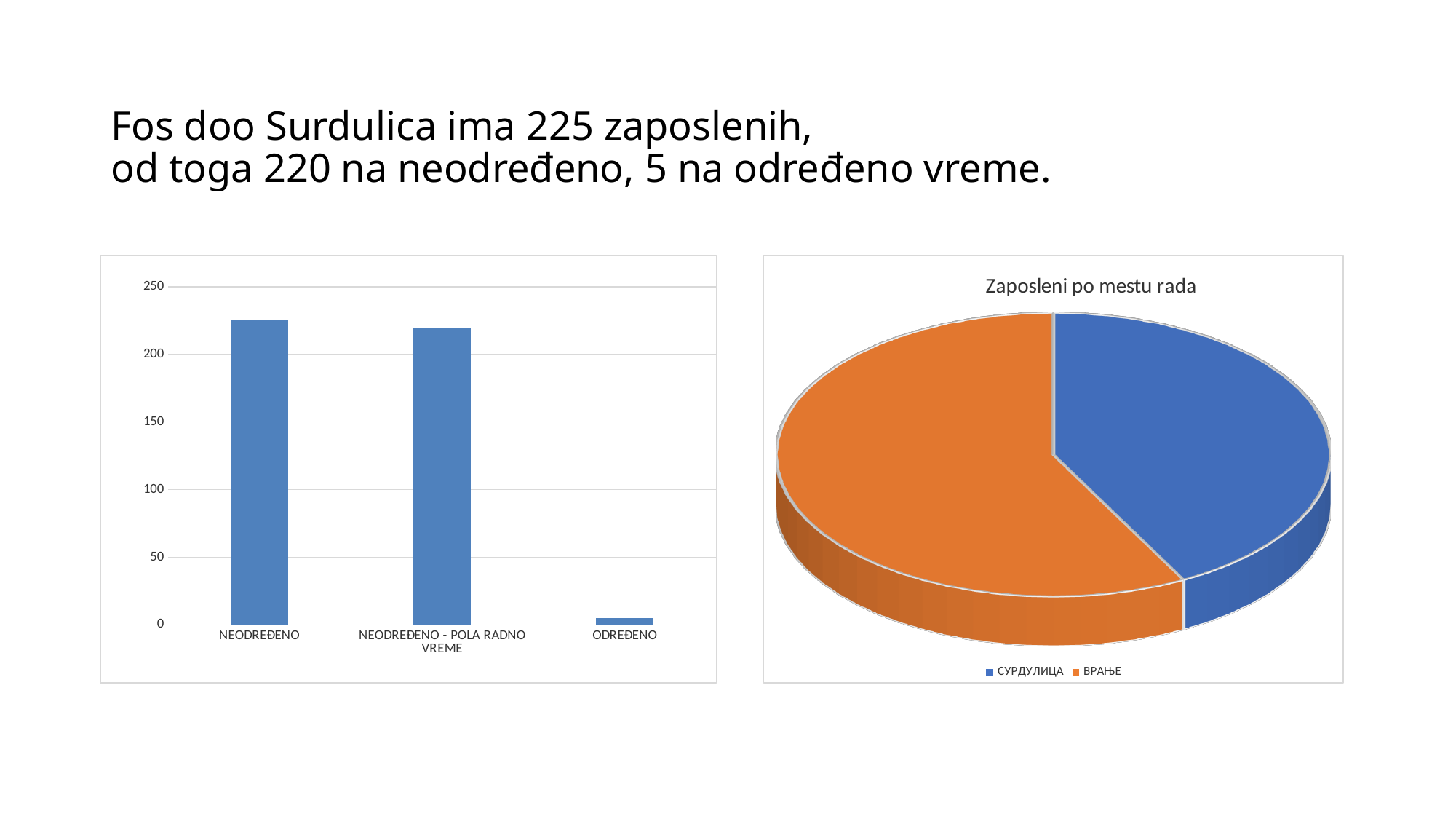
In the bar chart on the left, is the value for ODREĐENO greater or less than 50? less What kind of chart is the chart titled "Zaposleni po mestu rada"? pie chart In the pie chart "Zaposleni po mestu rada", how many slices are there? 2 In the pie chart "Zaposleni po mestu rada", which slice is larger: СУРДУЛИЦА or ВРАЊЕ? ВРАЊЕ In the bar chart on the left, how many categories are shown on the x axis? 3 In the bar chart on the left, is the value for NEODREĐENO - POLA RADNO VREME greater or less than 200? greater In the pie chart "Zaposleni po mestu rada", what colour is the СУРДУЛИЦА slice? blue In the bar chart on the left, which is larger: the value for NEODREĐENO or the value for ODREĐENO? NEODREĐENO What kind of chart is the chart on the left of the slide? bar chart In the bar chart on the left, is the value for NEODREĐENO greater or less than 200? greater In the bar chart on the left, which category has the lowest value? ODREĐENO In the bar chart on the left, what is the highest value shown on the vertical axis? 250